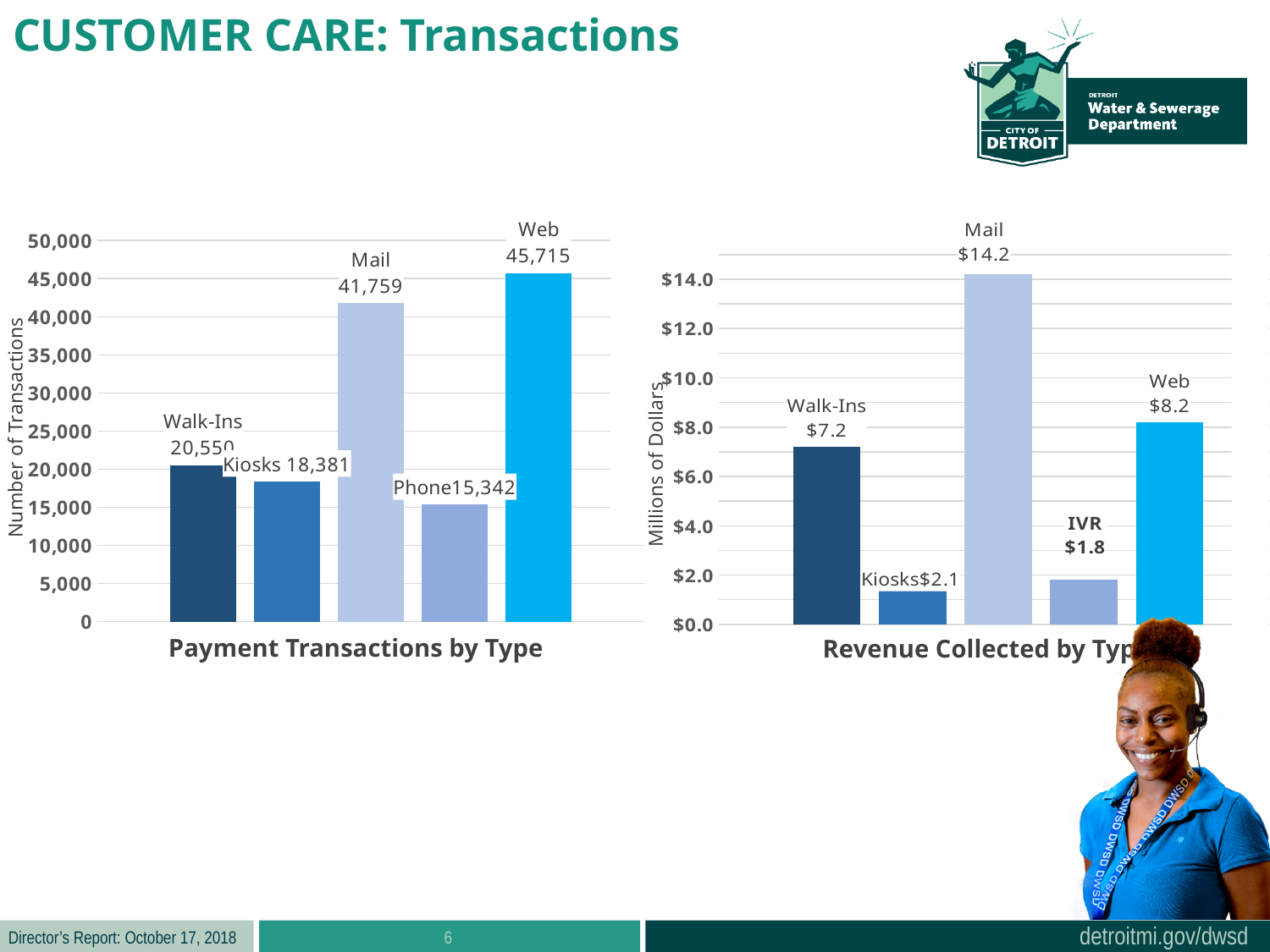
In the Payment Transactions by Type chart, what is the difference between Web and Mail transactions? 3,956 In the Revenue Collected by Type chart, which collected more revenue, Walk-Ins or Web? Web In the Payment Transactions by Type chart, how many payment types are shown? 5 In the Revenue Collected by Type chart, how much revenue was collected through IVR? $1.8 In the Revenue Collected by Type chart, how much revenue was collected by Mail? $14.2 In the Revenue Collected by Type chart, what is the difference between Mail and Web revenue? $6.0 In the Revenue Collected by Type chart, which type collected the least revenue? IVR In the Payment Transactions by Type chart, how many transactions were made by Mail? 41,759 In the Payment Transactions by Type chart, which payment type has the lowest number of transactions? Phone What kind of chart is the Revenue Collected by Type chart? Bar chart In the Payment Transactions by Type chart, which payment type has the highest number of transactions? Web In the Payment Transactions by Type chart, how many transactions were made by Phone? 15,342